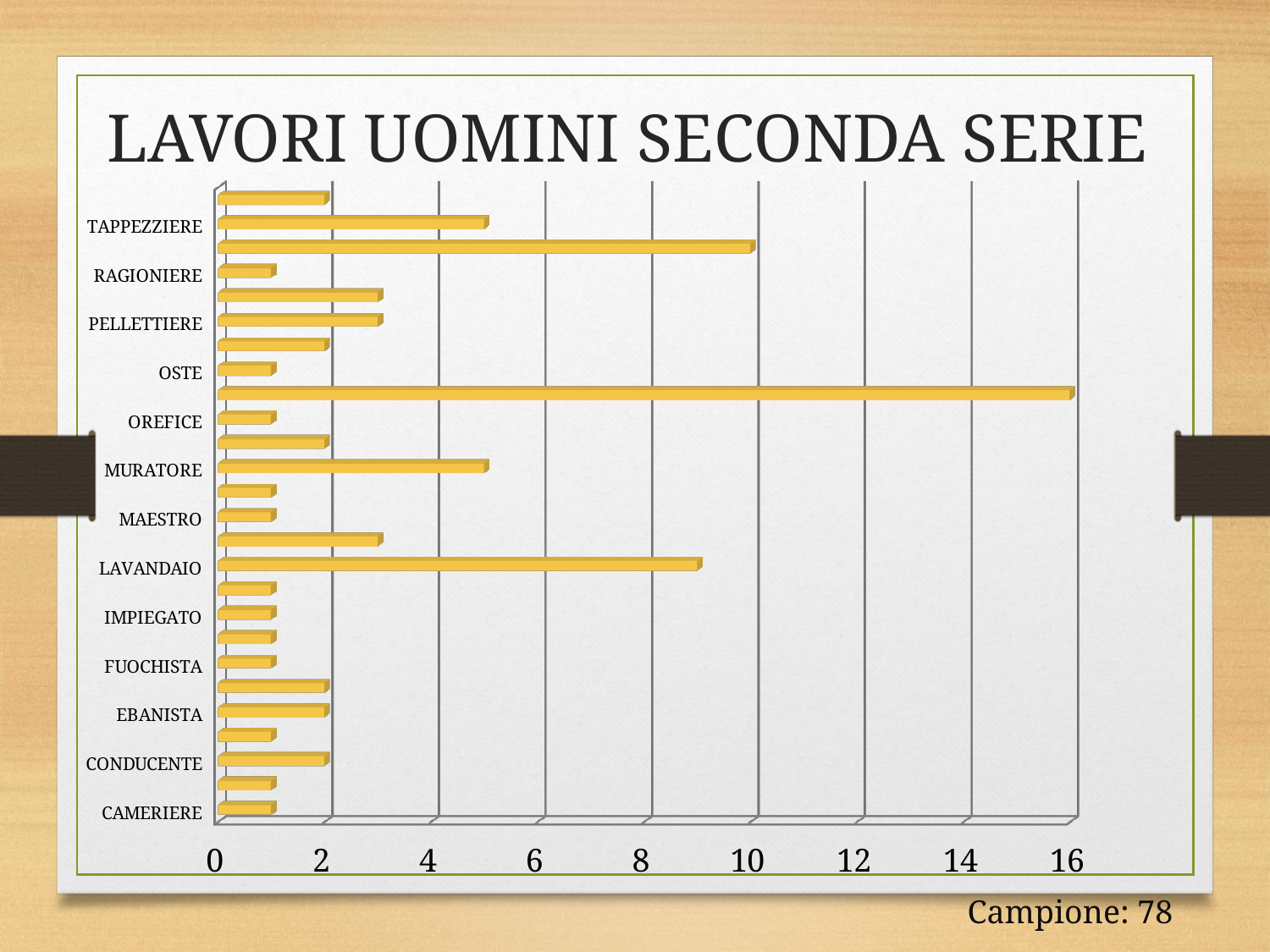
Is the value for LAVANDAIO greater or less than 8? greater Is the value for TAPPEZZIERE greater or less than 4? greater What sample size (Campione) is stated below the chart? 78 Is the value for MURATORE greater or less than 4? greater Which has the larger value, TAPPEZZIERE or RAGIONIERE? TAPPEZZIERE What is the title of the chart? LAVORI UOMINI SECONDA SERIE What kind of chart is shown on the slide? bar chart Which has the larger value, LAVANDAIO or IMPIEGATO? LAVANDAIO How many category labels are shown on the vertical axis of the chart? 13 Which has the larger value, MURATORE or MAESTRO? MURATORE